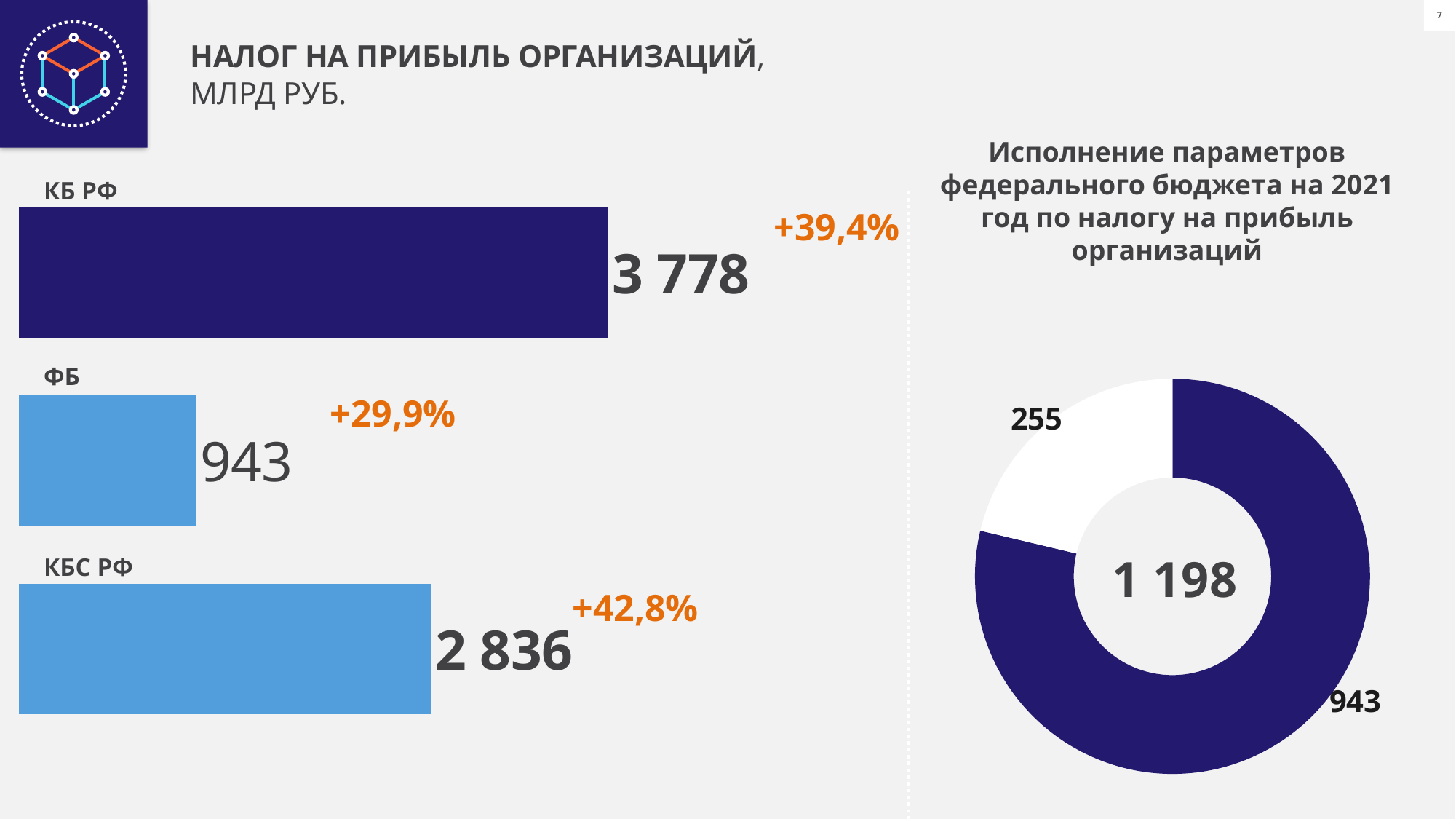
In the donut chart on the right, what is the total of the two segments 943 and 255? 1 198 In the bar chart on the left, what growth percentage is shown next to КБС РФ? +42,8% In the donut chart on the right, what value is shown in the centre? 1 198 In the bar chart on the left, which category has the highest value? КБ РФ In the bar chart on the left, which is larger: the value for ФБ or the value for КБС РФ? КБС РФ What kind of chart is shown on the left of the slide? Bar chart In the bar chart on the left, what is the value for ФБ? 943 In the bar chart on the left, what is the value for КБ РФ? 3 778 In the bar chart on the left, what is the value for КБС РФ? 2 836 In the bar chart on the left, what is the difference between the values for КБ РФ and КБС РФ? 942 In the bar chart on the left, which category has the lowest value? ФБ How many categories does the bar chart on the left show? 3